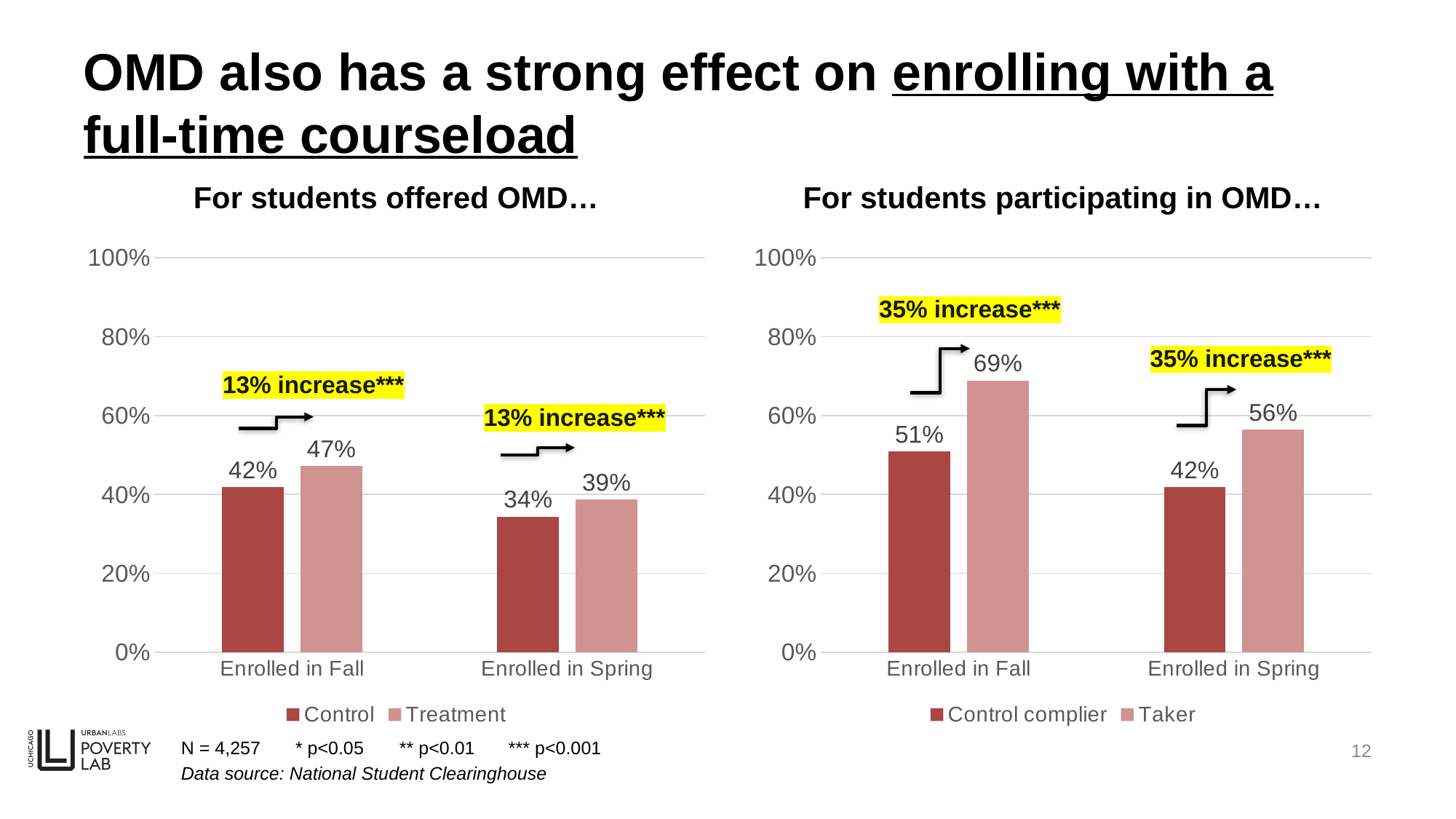
In the 'For students participating in OMD…' chart, which bar is the highest? Taker, Enrolled in Fall In the 'For students offered OMD…' chart, what is the difference between the Treatment and Control values for Enrolled in Fall? 5% In the 'For students participating in OMD…' chart, what is the difference between the Taker and Control complier values for Enrolled in Fall? 18% What kind of chart is the 'For students offered OMD…' chart? Bar chart In the 'For students offered OMD…' chart, what is the Treatment value for Enrolled in Fall? 47% In the 'For students participating in OMD…' chart, what is the Taker value for Enrolled in Fall? 69% How many series does the legend of the 'For students participating in OMD…' chart list? 2 In the 'For students offered OMD…' chart, what is the Control value for Enrolled in Spring? 34% In the 'For students offered OMD…' chart, which is larger for Enrolled in Spring: Control or Treatment? Treatment In the 'For students offered OMD…' chart, which bar is the lowest? Control, Enrolled in Spring In the 'For students participating in OMD…' chart, is the Taker value for Enrolled in Spring greater or less than 60%? less In the 'For students participating in OMD…' chart, what is the Control complier value for Enrolled in Spring? 42%